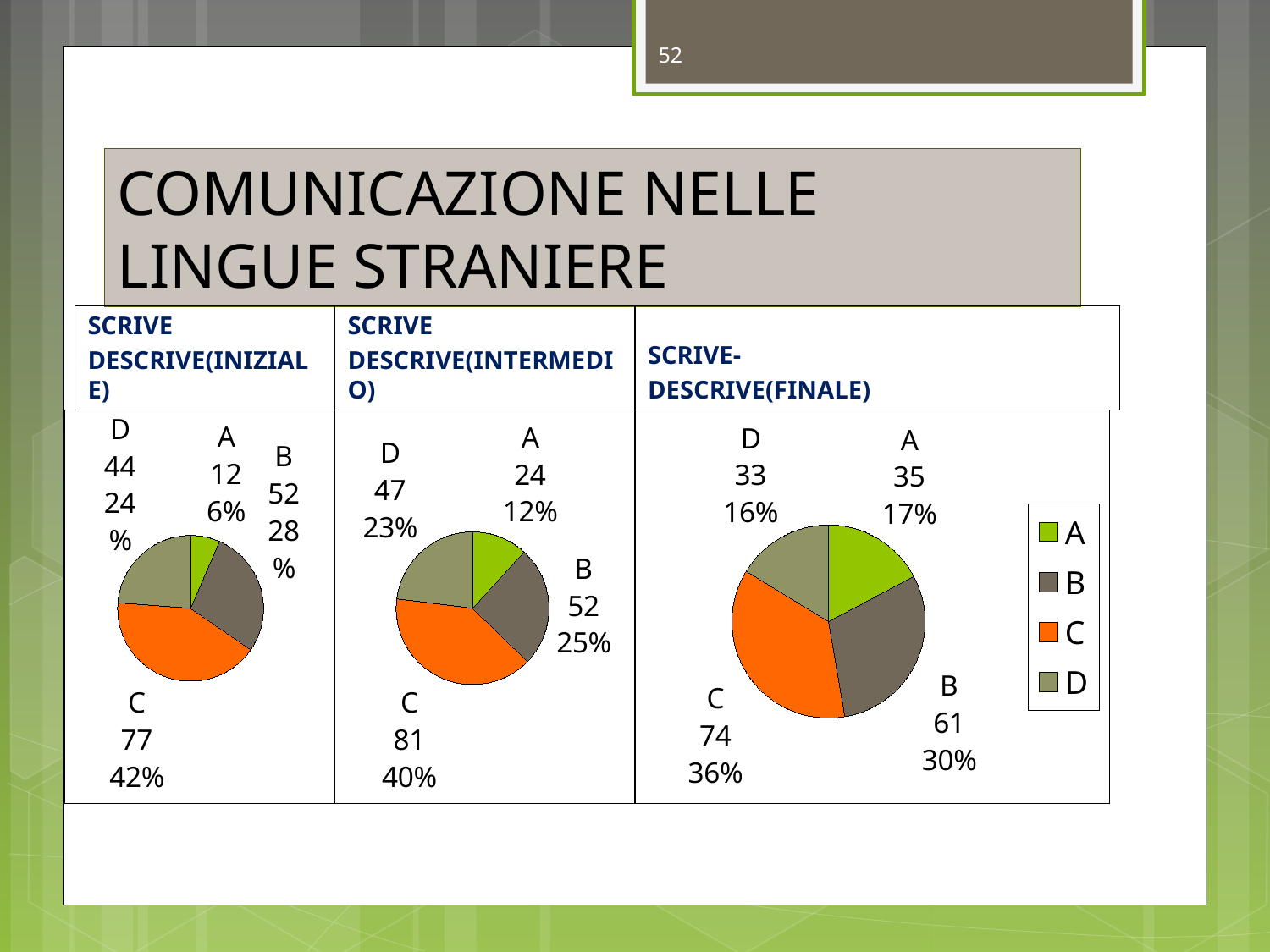
In the SCRIVE DESCRIVE(INIZIALE) chart, what percentage share does A have? 6% In the SCRIVE-DESCRIVE(FINALE) chart, what is the value for B? 61 In the SCRIVE DESCRIVE(INIZIALE) chart, which category has the smallest slice? A In the SCRIVE-DESCRIVE(FINALE) chart, which category has the largest slice? C Which colour represents category C in the legend on the right? Orange In the SCRIVE-DESCRIVE(FINALE) chart, what is the difference between the values for C and D? 41 In the SCRIVE DESCRIVE(INTERMEDIO) chart, what percentage share does B have? 25% In the SCRIVE DESCRIVE(INIZIALE) chart, what is the value for C? 77 How many categories does the SCRIVE-DESCRIVE(FINALE) chart show? 4 In the SCRIVE DESCRIVE(INTERMEDIO) chart, what is the value for D? 47 In the SCRIVE DESCRIVE(INTERMEDIO) chart, which is larger, the value for B or the value for D? B What kind of chart is the SCRIVE DESCRIVE(INIZIALE) chart? Pie chart